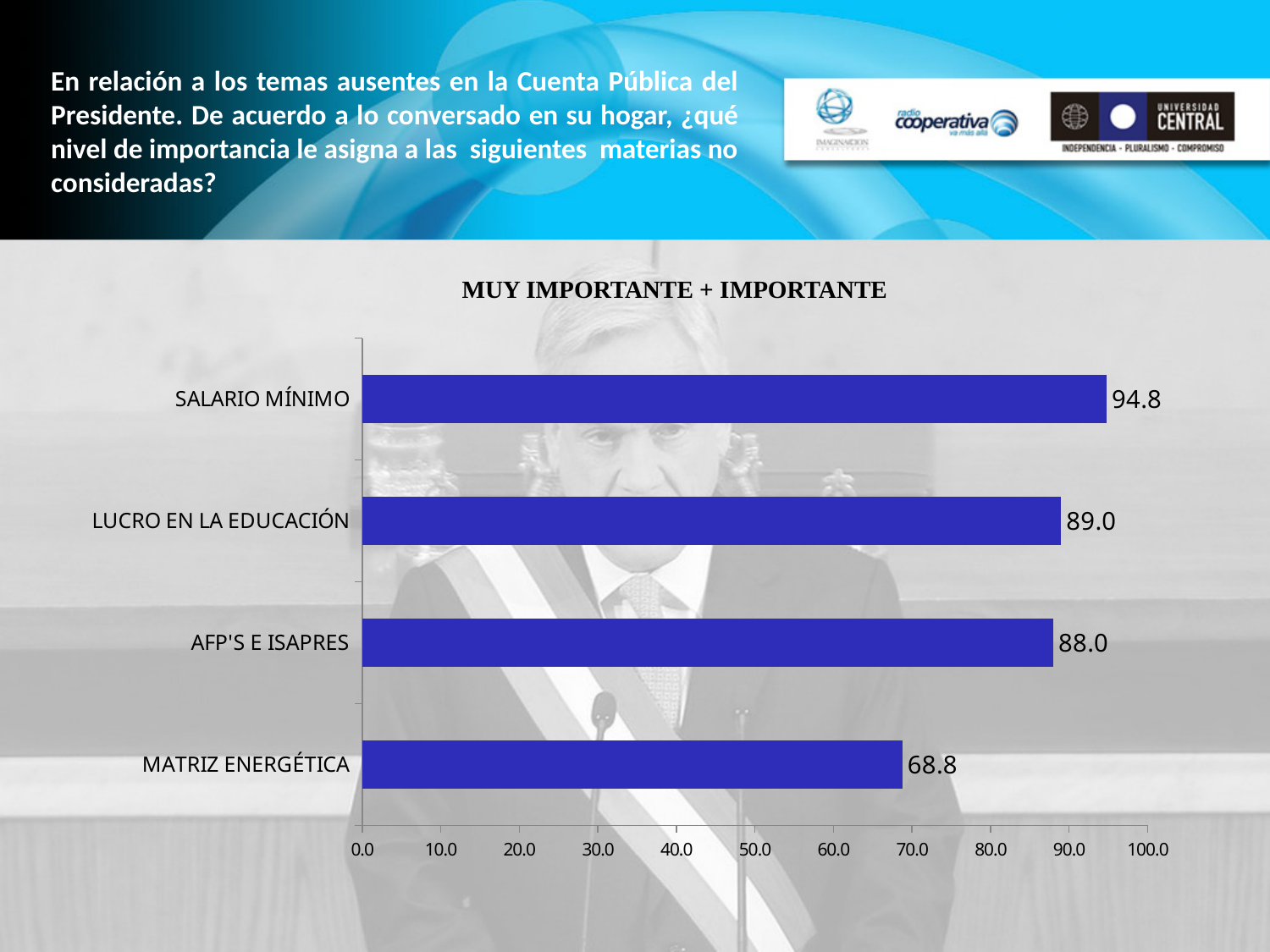
What is the value for SALARIO MÍNIMO? 94.8 What is the value for AFP'S E ISAPRES? 88.0 What is the value for MATRIZ ENERGÉTICA? 68.8 Which category has the lowest value? MATRIZ ENERGÉTICA Which category has the highest value? SALARIO MÍNIMO What is the difference between the values for SALARIO MÍNIMO and MATRIZ ENERGÉTICA? 26.0 How many categories are shown in the chart? 4 What is the difference between the values for LUCRO EN LA EDUCACIÓN and AFP'S E ISAPRES? 1.0 What is the title of the chart? MUY IMPORTANTE + IMPORTANTE What kind of chart is shown on the slide? Bar chart Which is larger, the value for SALARIO MÍNIMO or the value for MATRIZ ENERGÉTICA? SALARIO MÍNIMO What is the value for LUCRO EN LA EDUCACIÓN? 89.0